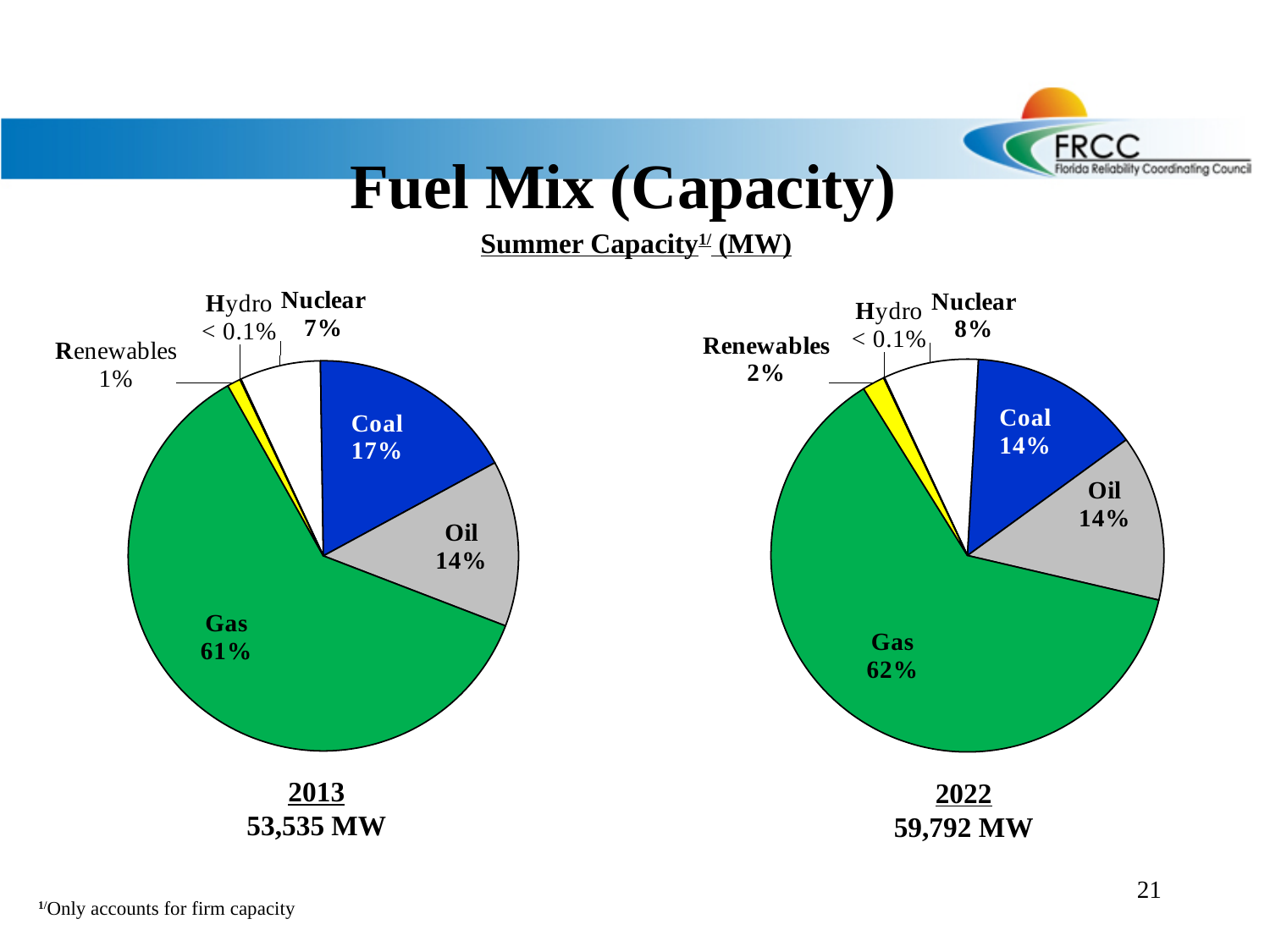
In the 2013 pie chart, what is the difference between the Coal share and the Oil share? 3% In the 2022 pie chart, which fuel has the smallest share? Hydro In the 2022 pie chart, which is larger, the Nuclear share or the Renewables share? Nuclear In the 2013 pie chart, what share of summer capacity is Gas? 61% In the 2022 pie chart, what share of summer capacity is Coal? 14% What kind of chart is used to show the 2022 fuel mix? Pie chart In the 2022 pie chart, what is the share for Renewables? 2% In the 2013 pie chart, which fuel has the largest share? Gas What total summer capacity in MW is shown below the 2022 pie chart? 59,792 MW In the 2013 pie chart, what is the share for Nuclear? 7% In the 2013 pie chart, what colour is the Gas slice? Green How many fuel categories are shown in the 2013 pie chart? 6